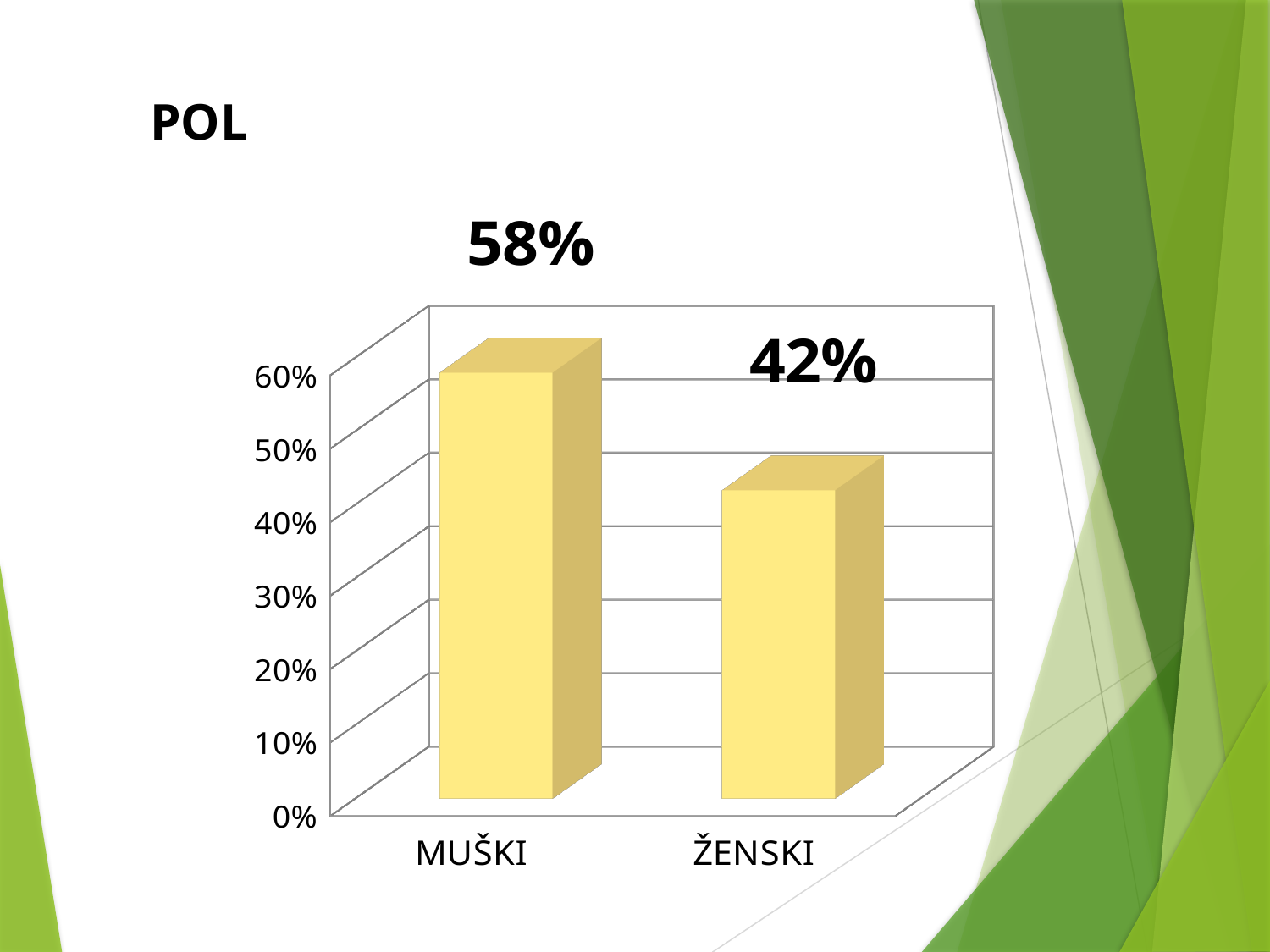
What is the value for ŽENSKI? 42% What is the value for MUŠKI? 58% Is the value for MUŠKI greater or less than 50%? greater Which is larger, the value for MUŠKI or the value for ŽENSKI? MUŠKI Which category has the lowest value? ŽENSKI What is the title of the slide? POL Which category has the highest value? MUŠKI What kind of chart is shown on the slide? bar chart What is the difference between the values for MUŠKI and ŽENSKI? 16% What is the highest value shown on the vertical axis? 60% How many categories are shown on the x axis? 2 Is the value for ŽENSKI greater or less than 50%? less